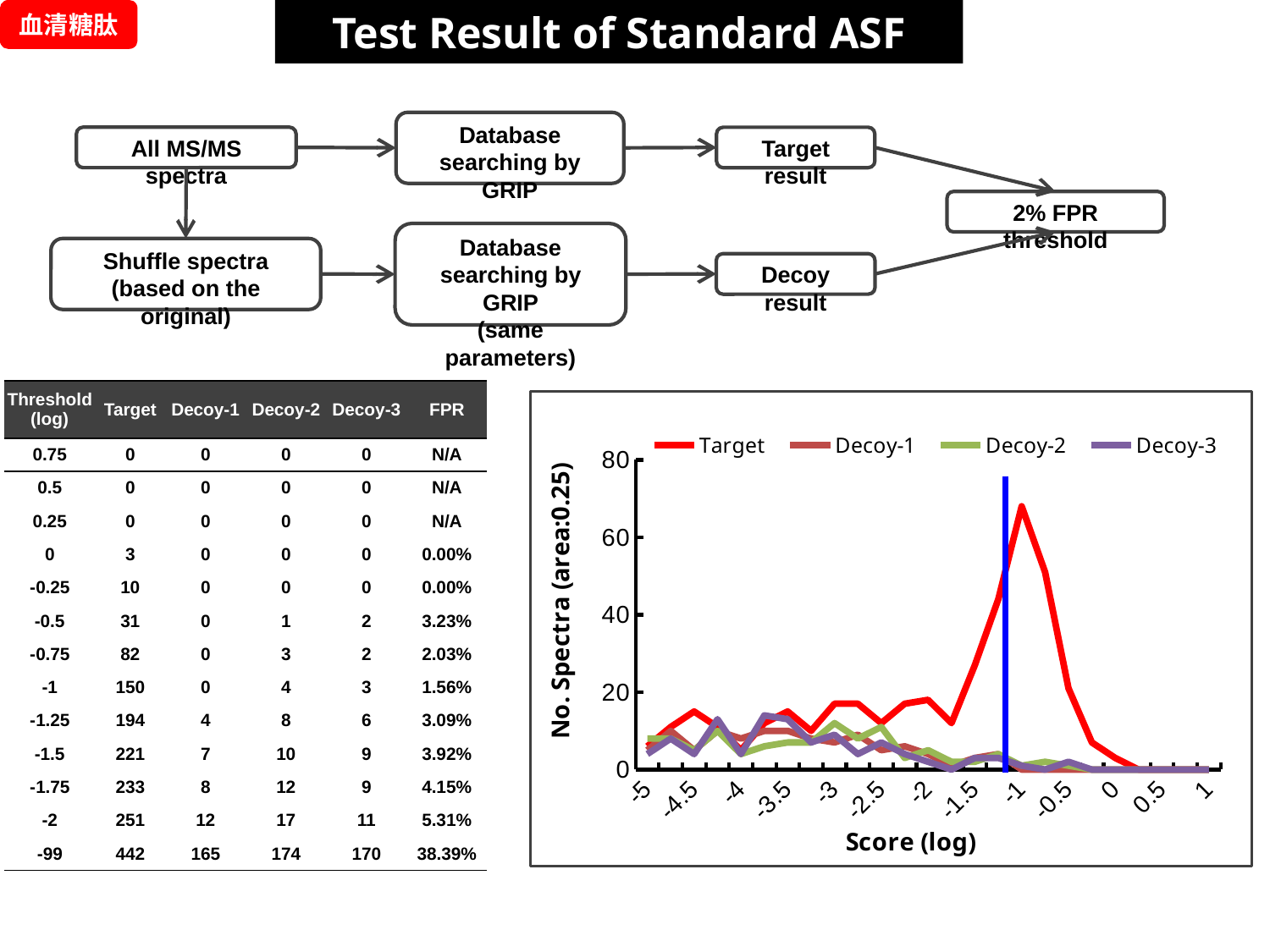
What is the title of the x axis of the line chart? Score (log) Which series in the line chart reaches the highest value? Target How many labeled tick marks are on the x axis of the line chart? 13 What kind of chart is shown on the right side of the slide? line chart In the line chart, at a score of -1, which is larger: Target or Decoy-3? Target In the line chart, is the value for Target at a score of -1.5 greater or less than 20? greater In the line chart, does the Target series rise or fall between scores of -2 and -1? rise In the line chart, does the Target series rise or fall between scores of -1 and 0? fall How many series does the legend of the line chart list? 4 In the line chart, is the value for Target at a score of -1 greater or less than 60? greater In the line chart, is the value for Decoy-2 at a score of -1 greater or less than 20? less What is the title of the y axis of the line chart? No. Spectra (area:0.25)